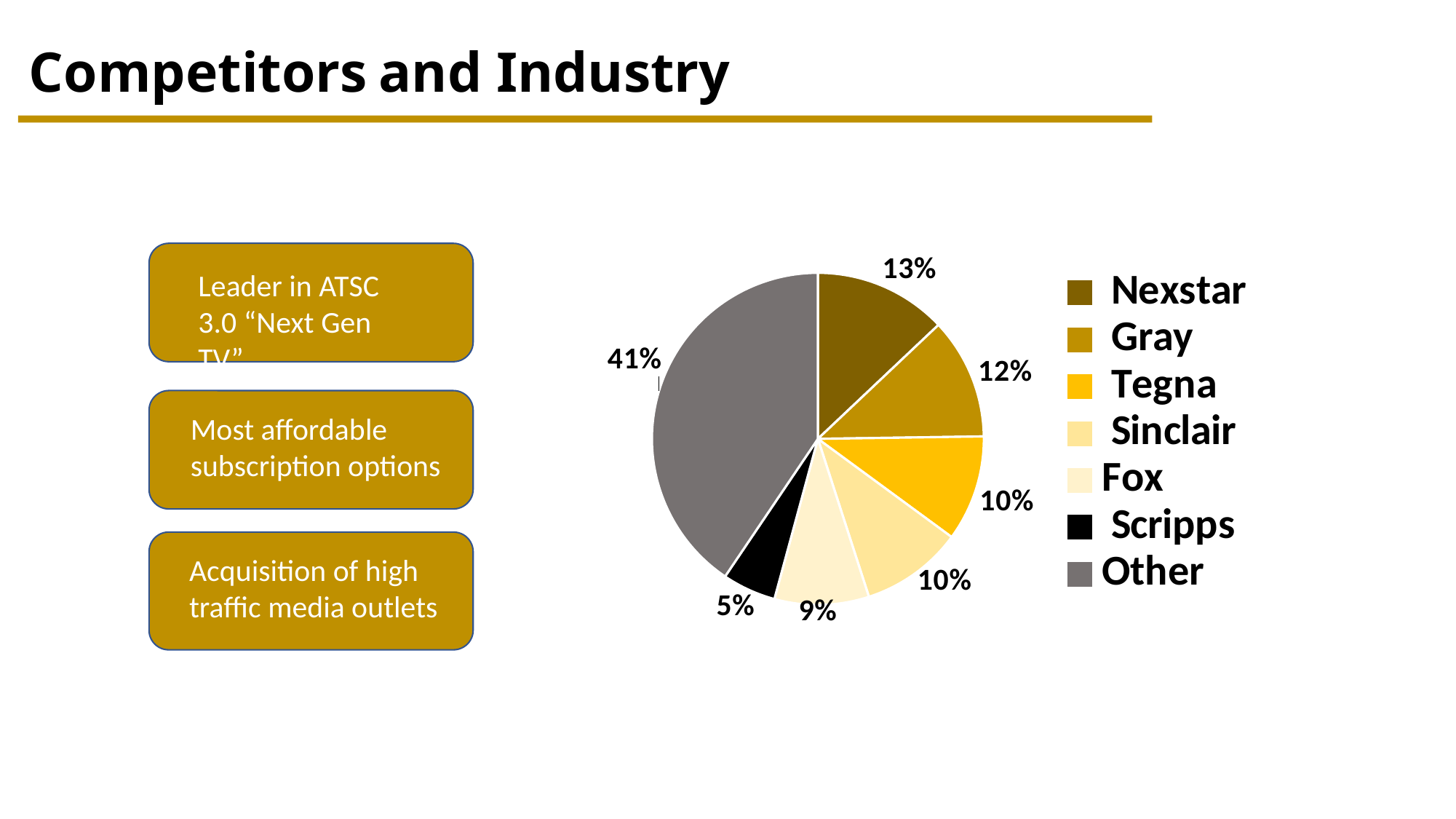
Which slice of the pie is the smallest? Scripps How many entries does the legend list? 7 Which is larger, the Gray slice or the Fox slice? Gray What is the difference in percentage points between the Other slice and the Nexstar slice? 28 What share of the pie does Other hold? 41% What share of the pie does Fox hold? 9% What share of the pie does Scripps hold? 5% What colour is the Scripps slice in the pie chart? black What kind of chart is shown on the slide? pie chart Which slice of the pie is the largest? Other What share of the pie does Gray hold? 12% What share of the pie does Nexstar hold? 13%